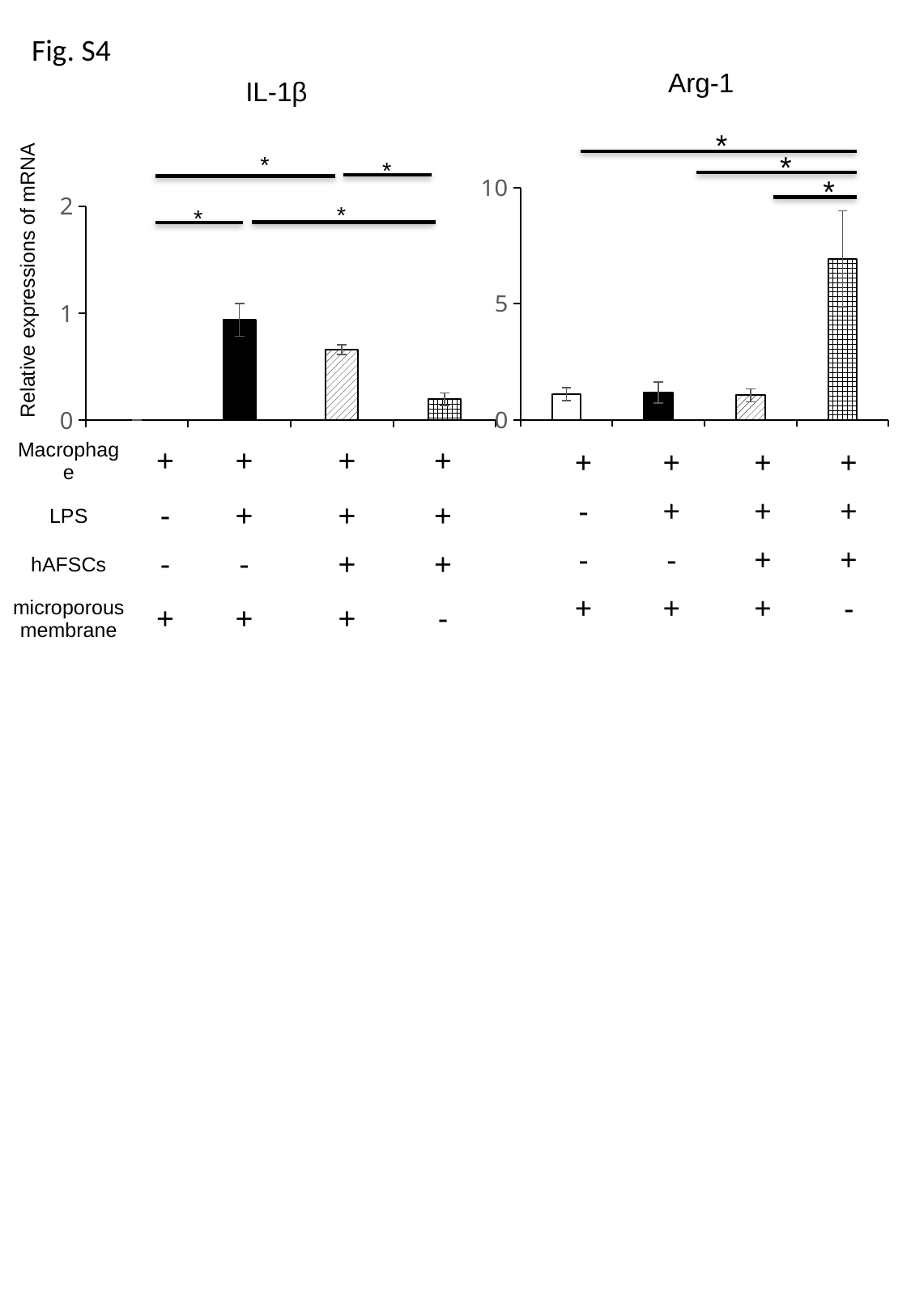
What is the title of the chart on the right? Arg-1 In the IL-1β chart, which bar is the highest? the second bar (Macrophage +, LPS +, hAFSCs -, microporous membrane +) In the IL-1β chart, is the value of the third bar (LPS +, hAFSCs +, microporous membrane +) greater or less than 1? less In the Arg-1 chart, which is larger: the second bar (LPS only) or the fourth bar (LPS + hAFSCs without membrane)? the fourth bar What kind of chart is the IL-1β chart on the left? bar chart In the Arg-1 chart, which bar is the highest? the fourth bar (Macrophage +, LPS +, hAFSCs +, microporous membrane -) In the Arg-1 chart, is the value of the first bar (LPS -) greater or less than 5? less How many bars are plotted in the Arg-1 chart on the right? 4 In the IL-1β chart, which bar is the lowest? the first bar (Macrophage +, LPS -, hAFSCs -, microporous membrane +) In the IL-1β chart, which is larger: the second bar (LPS only) or the fourth bar (LPS + hAFSCs without membrane)? the second bar In the Arg-1 chart, is the value of the fourth bar (without microporous membrane) greater or less than 5? greater What is the y-axis label shared by the two charts? Relative expressions of mRNA